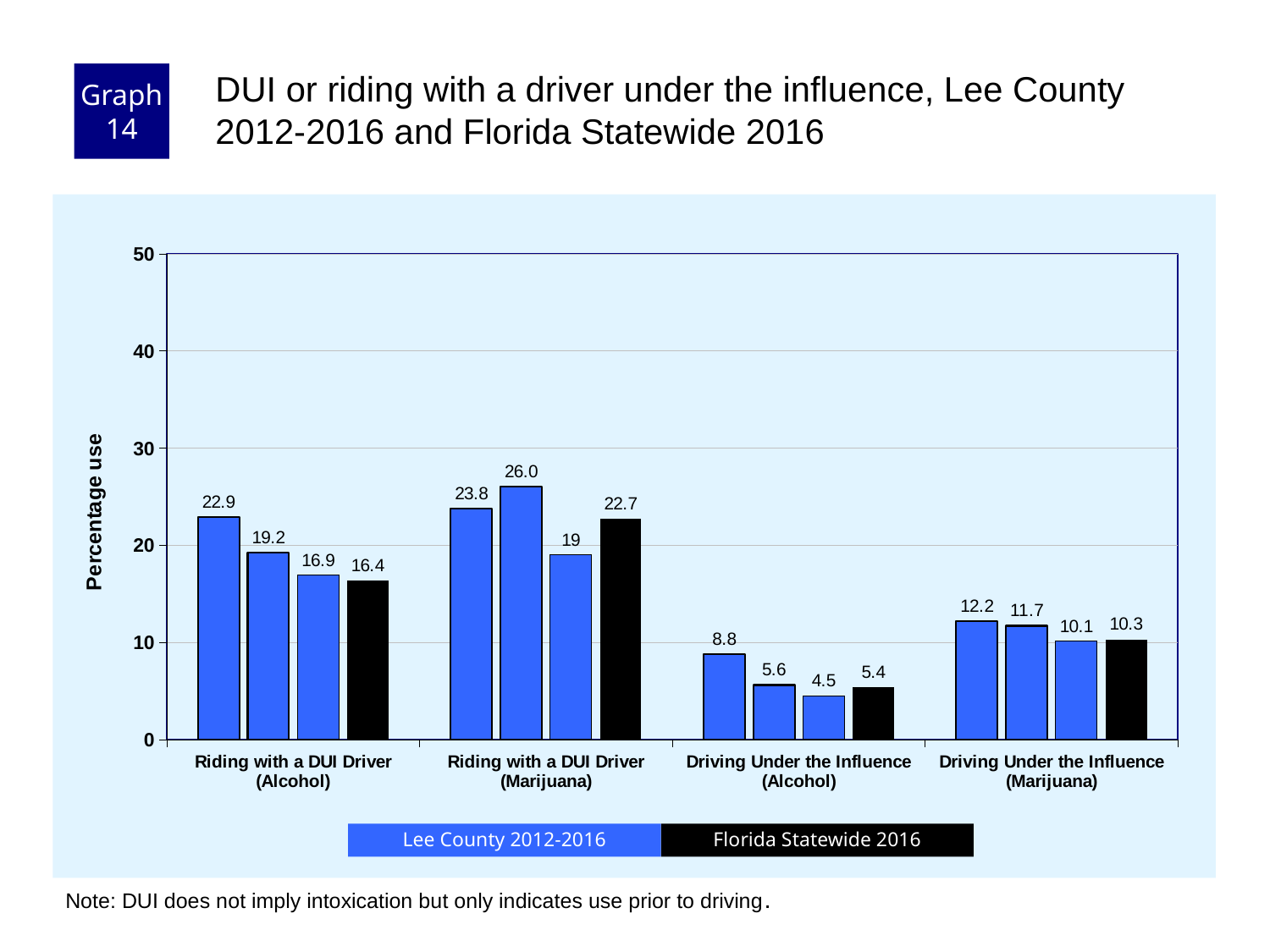
What is the Florida Statewide 2016 value for Driving Under the Influence (Alcohol)? 5.4 What is the value of the first Lee County bar in the Riding with a DUI Driver (Alcohol) group? 22.9 Is the Florida Statewide 2016 value for Riding with a DUI Driver (Alcohol) greater or less than 20? less What kind of chart is shown on the slide? bar chart How many series does the legend list? 2 What is the highest value shown on the chart? 26.0 Which category contains the lowest value on the chart? Driving Under the Influence (Alcohol) What is the Florida Statewide 2016 value for Riding with a DUI Driver (Marijuana)? 22.7 What is the difference between the Florida Statewide 2016 values for Driving Under the Influence (Marijuana) and Driving Under the Influence (Alcohol)? 4.9 Which is larger: the Florida Statewide 2016 value for Riding with a DUI Driver (Alcohol) or for Riding with a DUI Driver (Marijuana)? Riding with a DUI Driver (Marijuana) What is the difference between the first Lee County bar (22.9) and the Florida Statewide 2016 bar in the Riding with a DUI Driver (Alcohol) group? 6.5 How many categories are shown on the x axis? 4